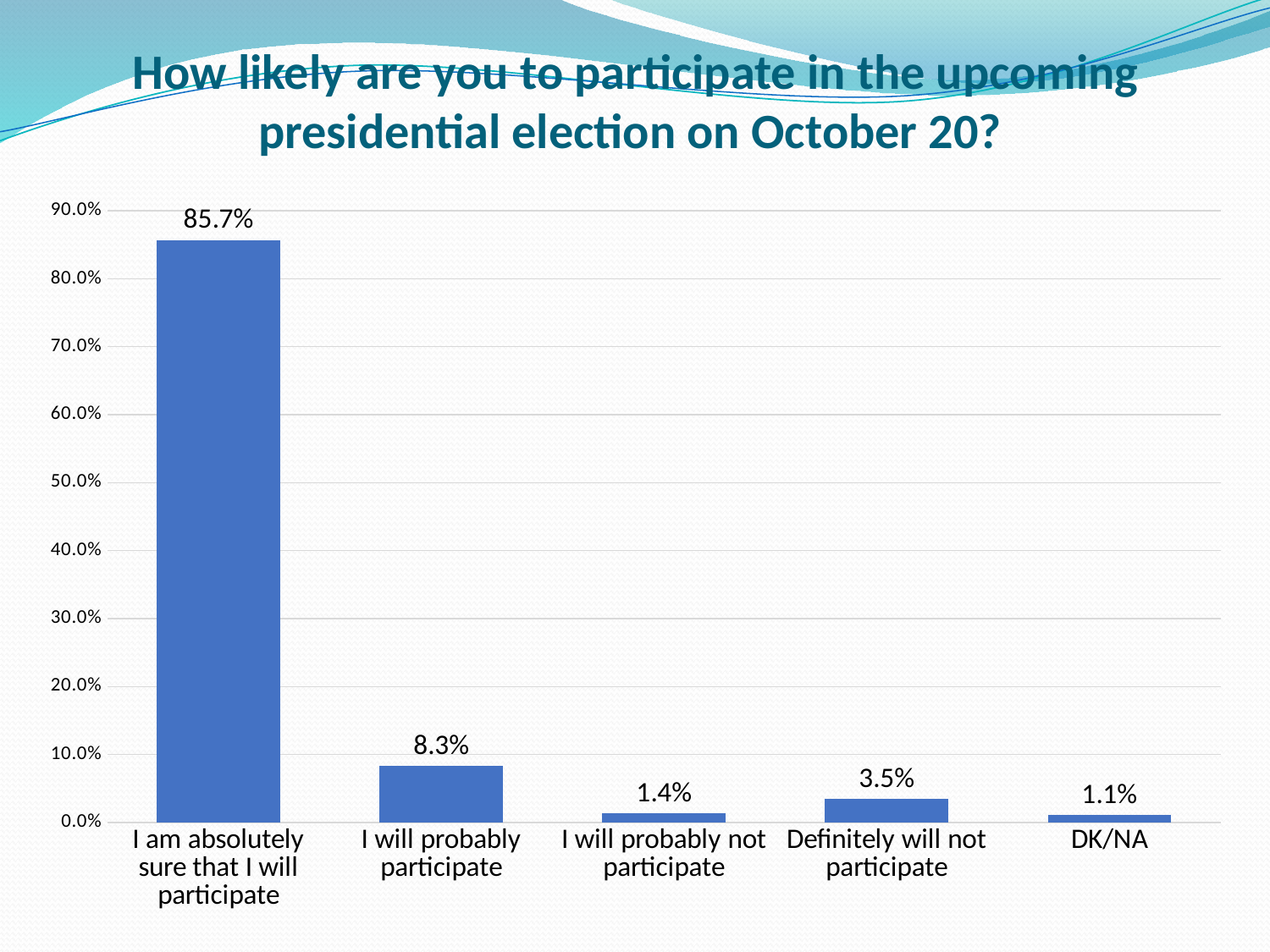
What kind of chart is shown on the slide? Bar chart What is the value for DK/NA? 1.1% Which category has the highest value? I am absolutely sure that I will participate How many categories are shown on the chart? 5 What is the value for 'I will probably participate'? 8.3% What is the title of the slide? How likely are you to participate in the upcoming presidential election on October 20? Which is larger: 'Definitely will not participate' or 'I will probably not participate'? Definitely will not participate What is the value for 'Definitely will not participate'? 3.5% Which category has the lowest value? DK/NA What percentage of respondents said they are absolutely sure that they will participate? 85.7% What is the difference between 'I will probably participate' and 'I will probably not participate'? 6.9% Is the value for 'I am absolutely sure that I will participate' greater or less than 80.0%? greater